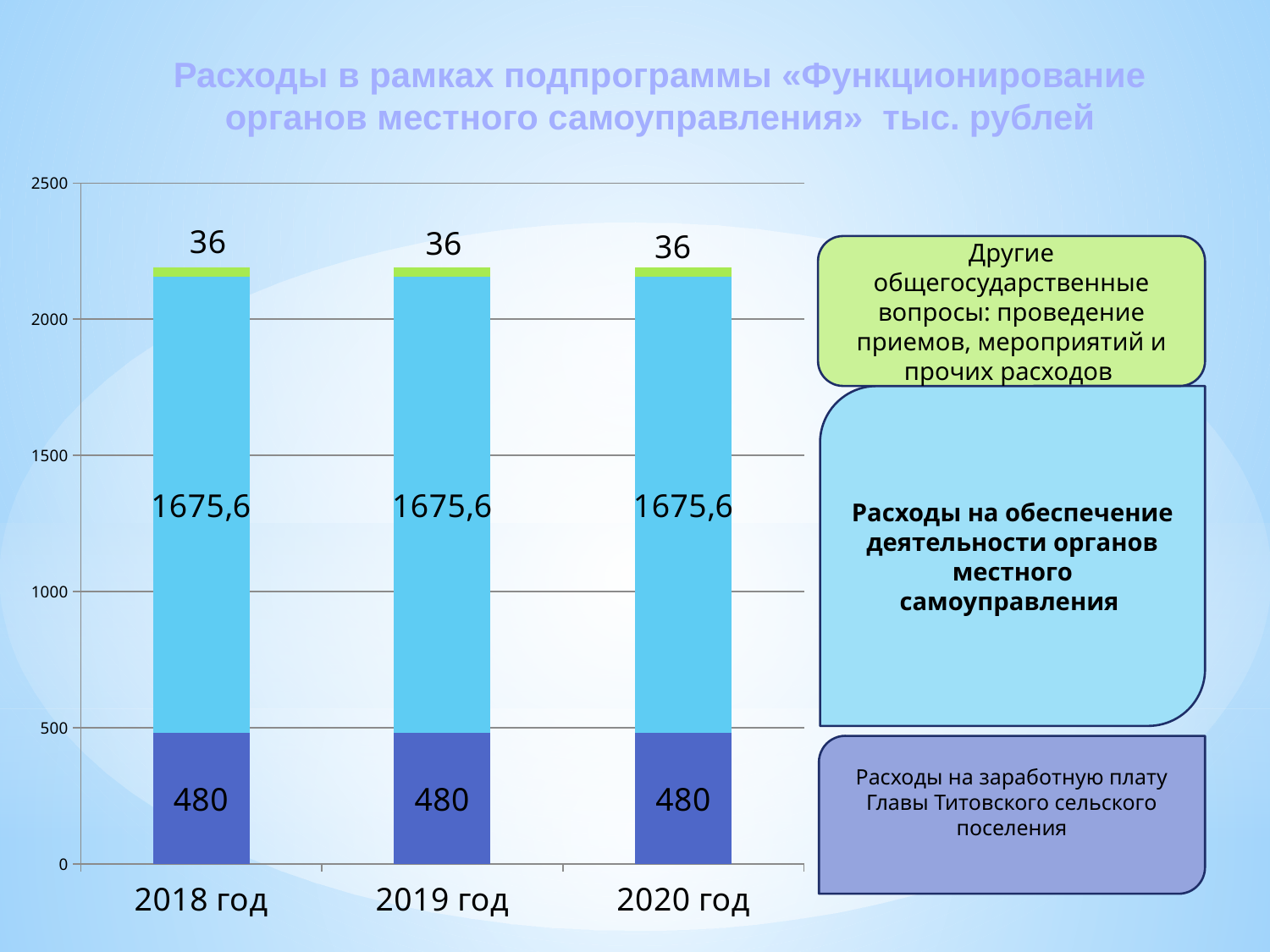
Is the total height of the 2019 год bar greater or less than 2000? greater How many years (categories) are shown on the x axis? 3 Which segment is the smallest in each bar? Другие общегосударственные вопросы What is the value of the 'Расходы на обеспечение деятельности органов местного самоуправления' segment for 2019 год? 1675,6 What is the value of the 'Расходы на заработную плату Главы Титовского сельского поселения' segment for 2018 год? 480 Which segment is the largest in each bar? Расходы на обеспечение деятельности органов местного самоуправления What is the difference between the 'Расходы на обеспечение деятельности органов местного самоуправления' segment and the 'Расходы на заработную плату Главы' segment in 2020 год? 1195,6 What is the value of the 'Другие общегосударственные вопросы' segment for 2020 год? 36 Which segment is larger in 2019 год: 'Расходы на заработную плату Главы' or 'Другие общегосударственные вопросы'? Расходы на заработную плату Главы What kind of chart is shown on the slide? stacked bar chart Do the total values of the bars rise, fall or stay the same from 2018 год to 2020 год? stay the same What is the total of the stacked bar for 2018 год? 2191,6